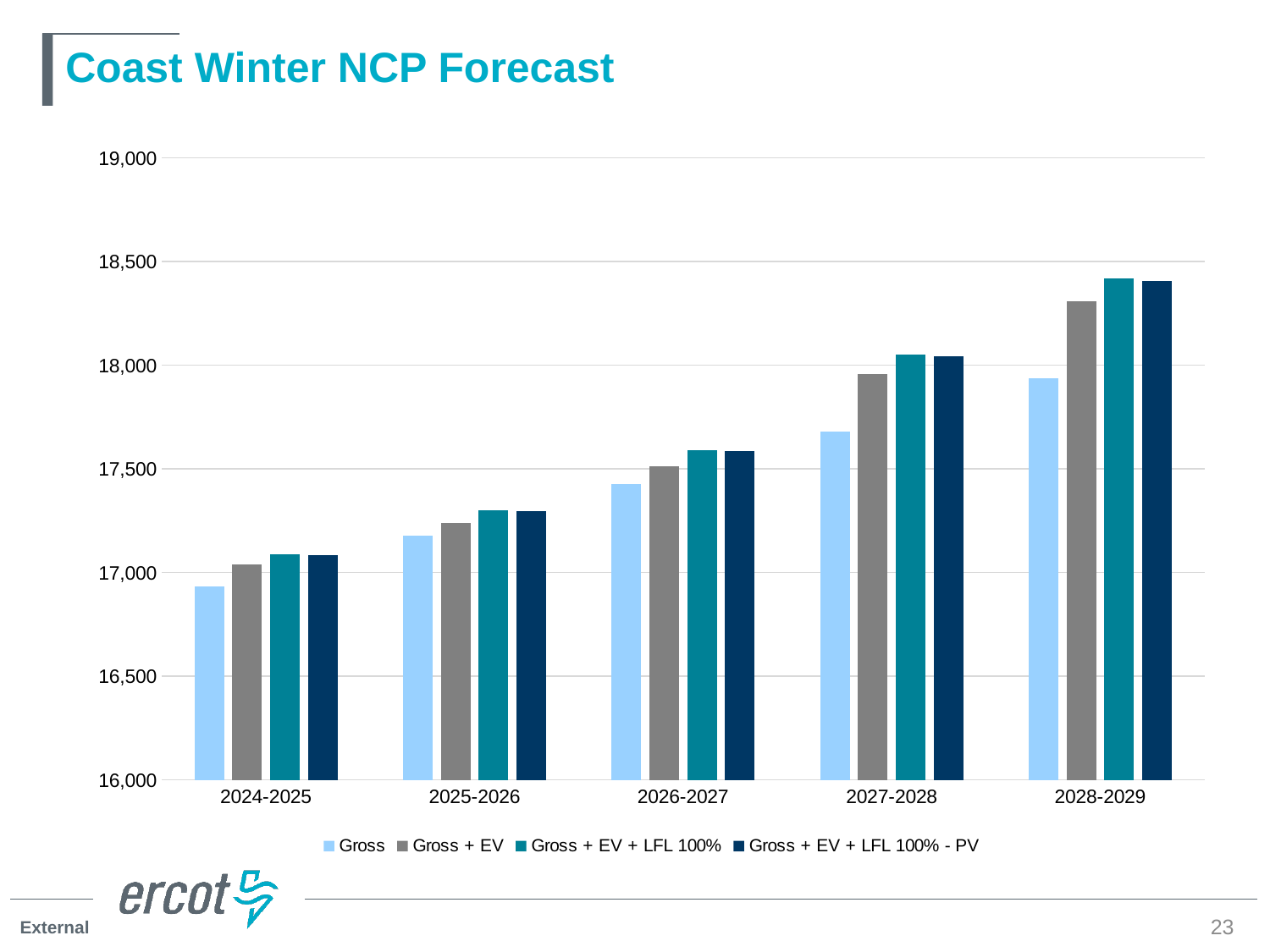
Is the Gross value for 2028-2029 greater or less than 18,000? less Which season has the highest Gross value? 2028-2029 What is the title of the chart? Coast Winter NCP Forecast How many series does the legend list? 4 Is the Gross + EV + LFL 100% value for 2027-2028 greater or less than 18,000? greater Is the Gross value for 2026-2027 greater or less than 17,500? less What kind of chart is shown on the slide? bar chart How many winter seasons are shown on the x axis? 5 Do the Gross values rise or fall from 2024-2025 to 2028-2029? rise Which season has the lowest Gross + EV + LFL 100% value? 2024-2025